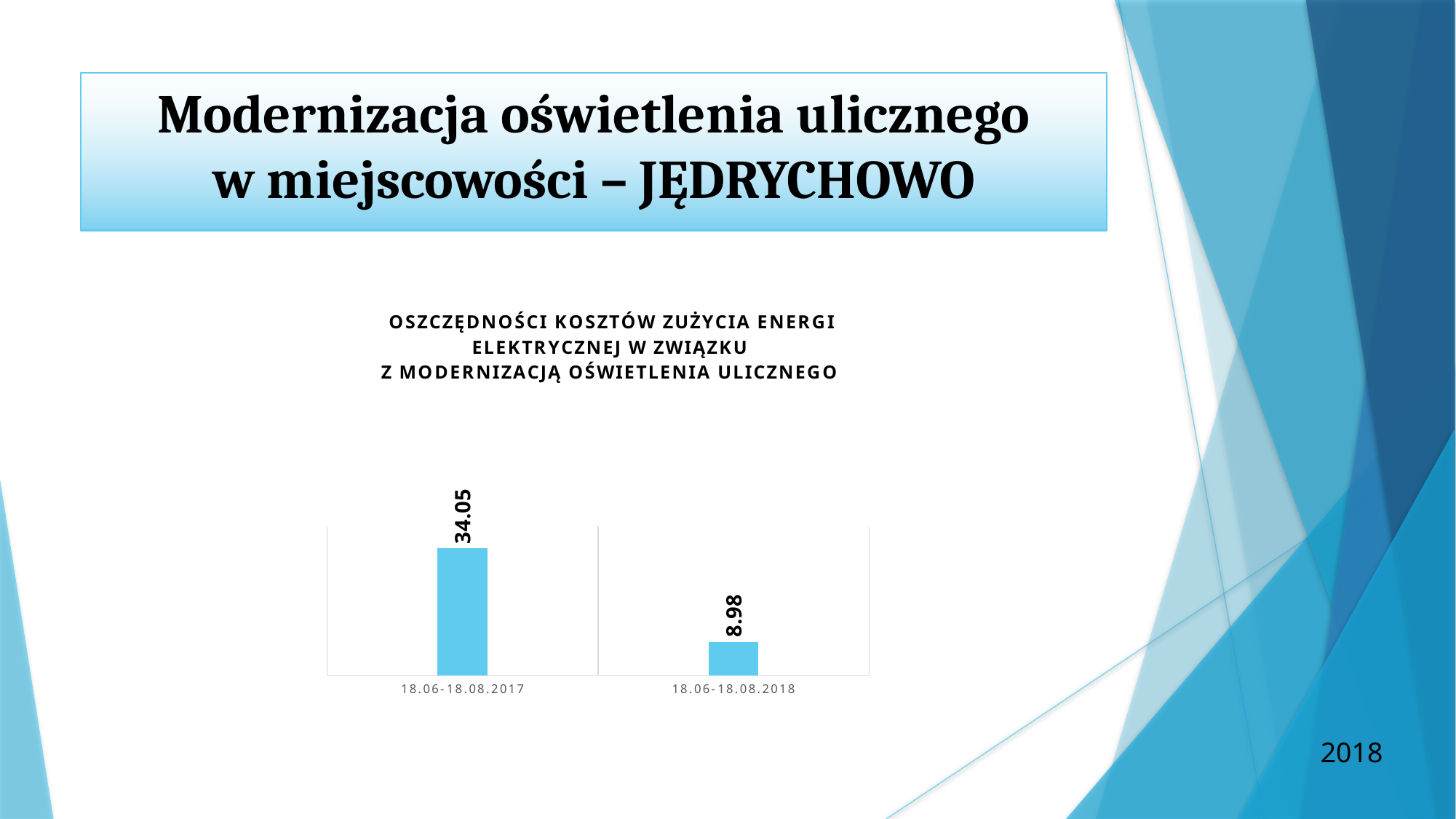
How many categories are shown in the chart? 2 Which category has the lowest value? 18.06-18.08.2018 What kind of chart is shown on the slide? Bar chart Which is larger, the value for 18.06-18.08.2017 or for 18.06-18.08.2018? 18.06-18.08.2017 Which category has the highest value? 18.06-18.08.2017 What is the value for 18.06-18.08.2017? 34.05 Do the values rise or fall from 18.06-18.08.2017 to 18.06-18.08.2018? Fall What is the difference between the values for 18.06-18.08.2017 and 18.06-18.08.2018? 25.07 What colour are the bars in the chart? Light blue What is the value for 18.06-18.08.2018? 8.98 What is the title of the chart? OSZCZĘDNOŚCI KOSZTÓW ZUŻYCIA ENERGI ELEKTRYCZNEJ W ZWIĄZKU Z MODERNIZACJĄ OŚWIETLENIA ULICZNEGO What is the total of the two values shown in the chart? 43.03